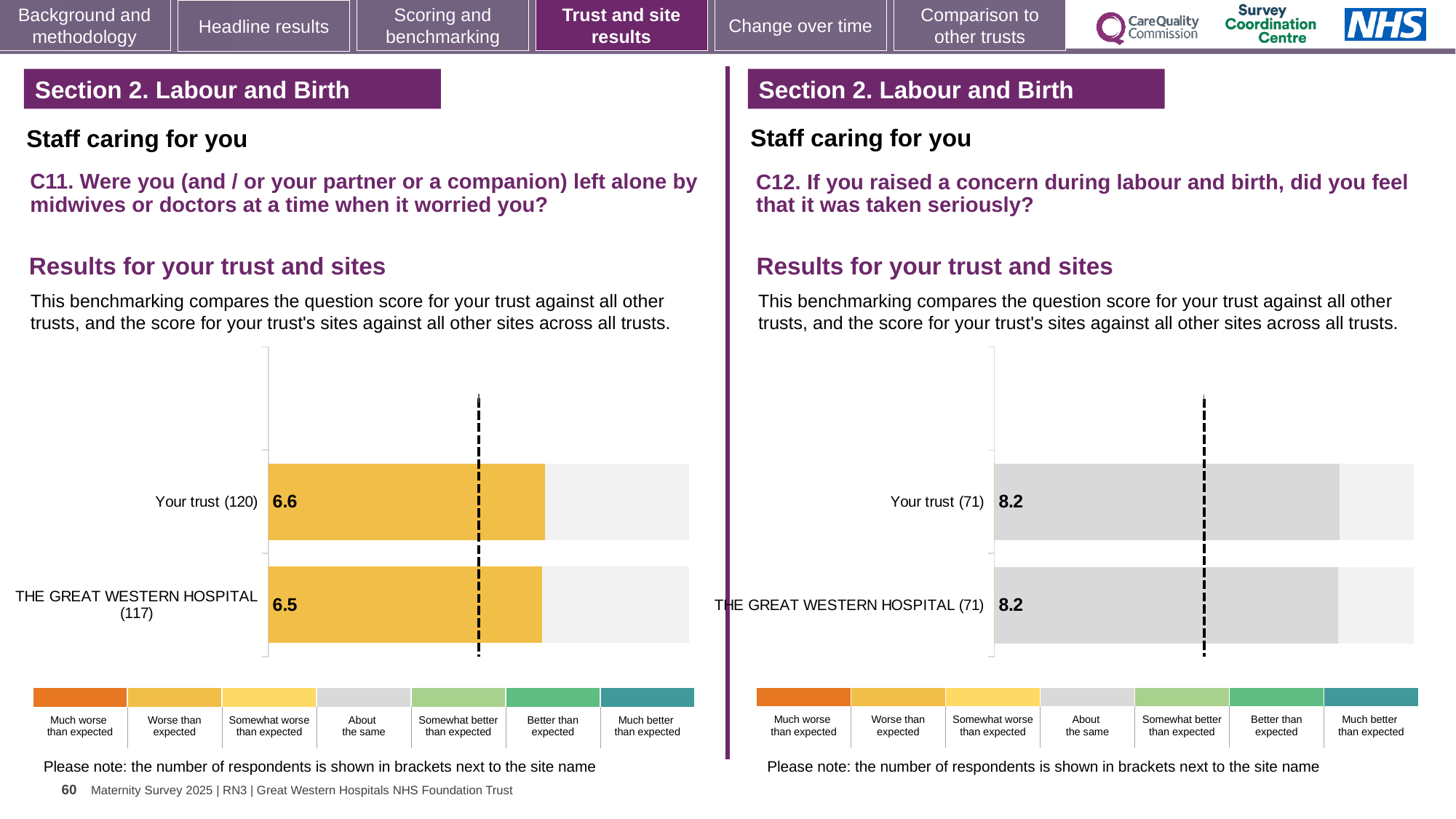
How many bars are plotted in the C11 chart on the left? 2 In the C12 chart on the right, what is the difference between the score for Your trust and the score for THE GREAT WESTERN HOSPITAL? 0 In the C12 chart on the right, what is the score for Your trust? 8.2 In the C12 chart on the right, how many respondents are shown in brackets for Your trust? 71 In the C12 chart on the right, what is the score for THE GREAT WESTERN HOSPITAL? 8.2 In the C11 chart on the left, which has the higher score, Your trust or THE GREAT WESTERN HOSPITAL? Your trust What kind of chart is the C11 chart on the left? Bar chart In the C11 chart on the left, what is the score for Your trust? 6.6 How many bars are plotted in the C12 chart on the right? 2 In the C11 chart on the left, how many respondents are shown in brackets for THE GREAT WESTERN HOSPITAL? 117 In the C11 chart on the left, what is the difference between the score for Your trust and the score for THE GREAT WESTERN HOSPITAL? 0.1 In the C11 chart on the left, what is the score for THE GREAT WESTERN HOSPITAL? 6.5